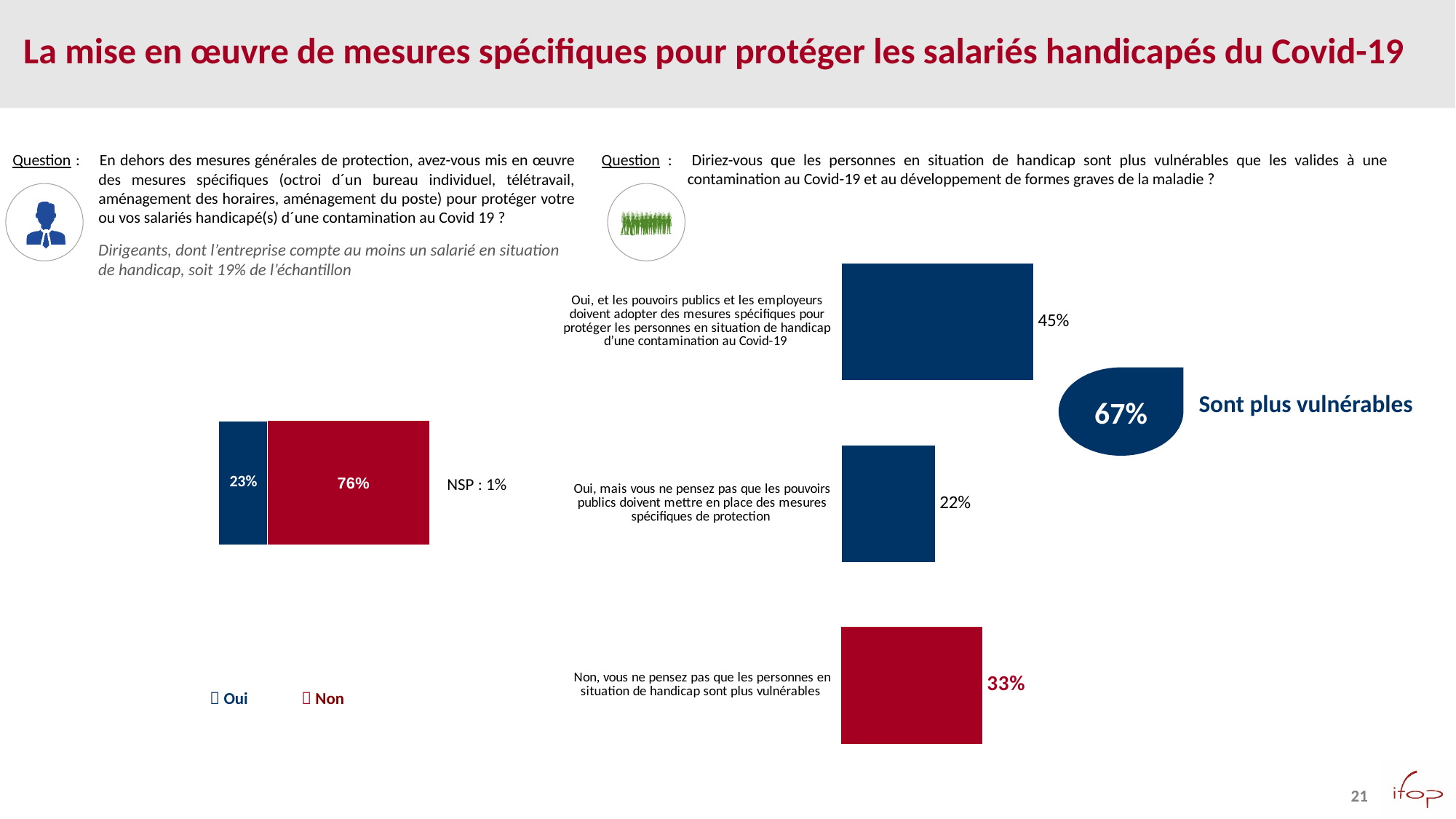
In the left chart, what percentage of respondents answered "Non"? 76% In the right chart, what percentage corresponds to "Oui, et les pouvoirs publics et les employeurs doivent adopter des mesures spécifiques..."? 45% In the left chart, which answer has the larger share, "Oui" or "Non"? Non In the left chart, what is the NSP percentage shown next to the bar? 1% In the right chart, what percentage corresponds to "Non, vous ne pensez pas que les personnes en situation de handicap sont plus vulnérables"? 33% In the right chart, how many categories are plotted? 3 In the left chart, how many entries does the legend list? 2 In the left chart, what is the difference between the "Non" and "Oui" percentages? 53 percentage points In the left chart, what percentage of respondents answered "Oui"? 23% In the right chart, which category has the lowest value? Oui, mais vous ne pensez pas que les pouvoirs publics doivent mettre en place des mesures spécifiques de protection In the right chart, what is the combined percentage shown in the callout for "Sont plus vulnérables"? 67% What type of chart is the right chart? Bar chart